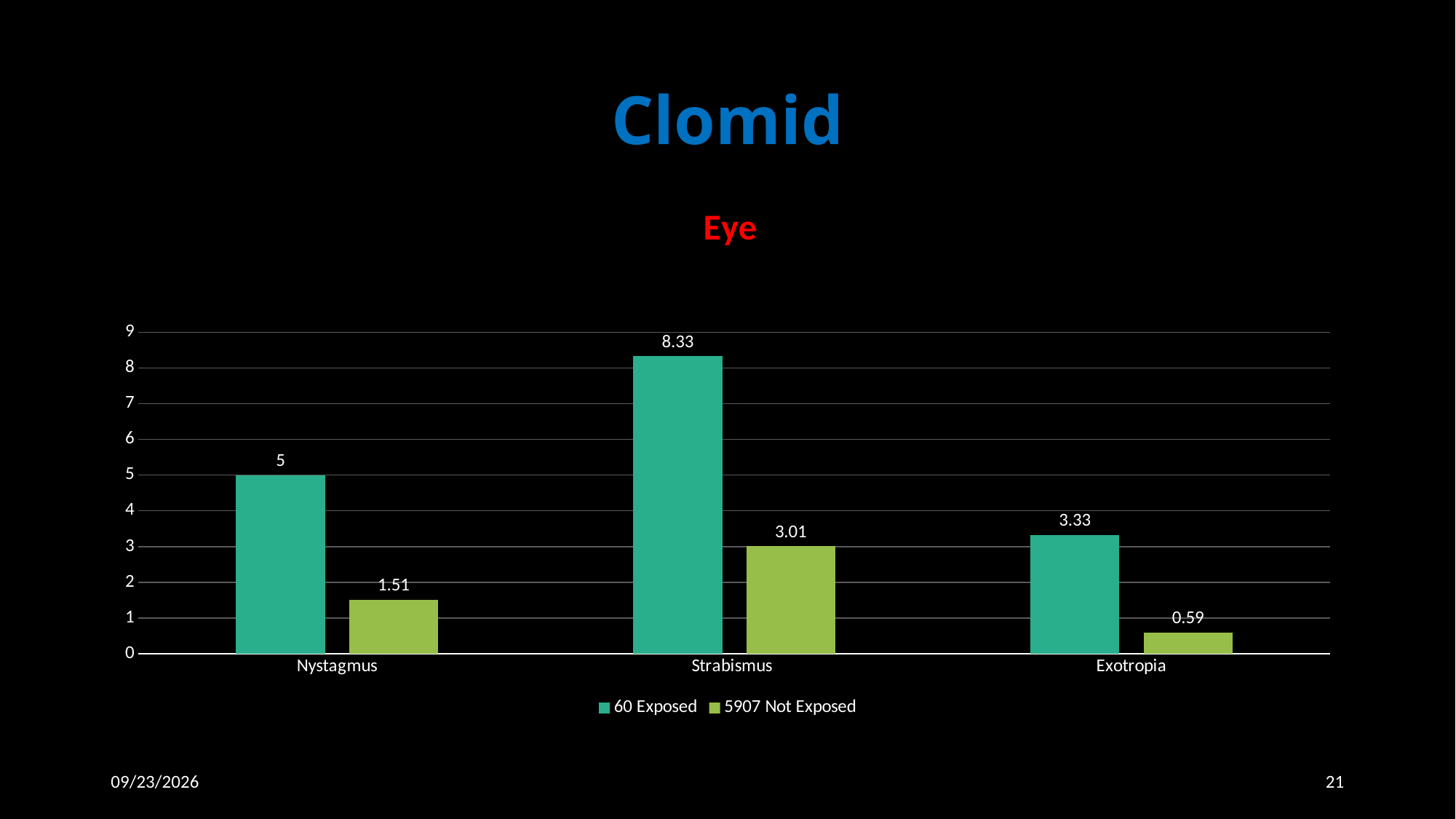
Which category has the highest value in the 60 Exposed series? Strabismus What is the chart's title? Eye What is the difference between the 60 Exposed and 5907 Not Exposed values for Strabismus? 5.32 How many series does the legend list? 2 How many categories are shown on the x axis? 3 Which is larger for Nystagmus: the 60 Exposed value or the 5907 Not Exposed value? 60 Exposed What is the value for Strabismus in the 5907 Not Exposed series? 3.01 What is the value for Exotropia in the 5907 Not Exposed series? 0.59 What is the value for Exotropia in the 60 Exposed series? 3.33 What is the value for Nystagmus in the 60 Exposed series? 5 What kind of chart is shown on the slide? Bar chart Which category has the lowest value in the 5907 Not Exposed series? Exotropia